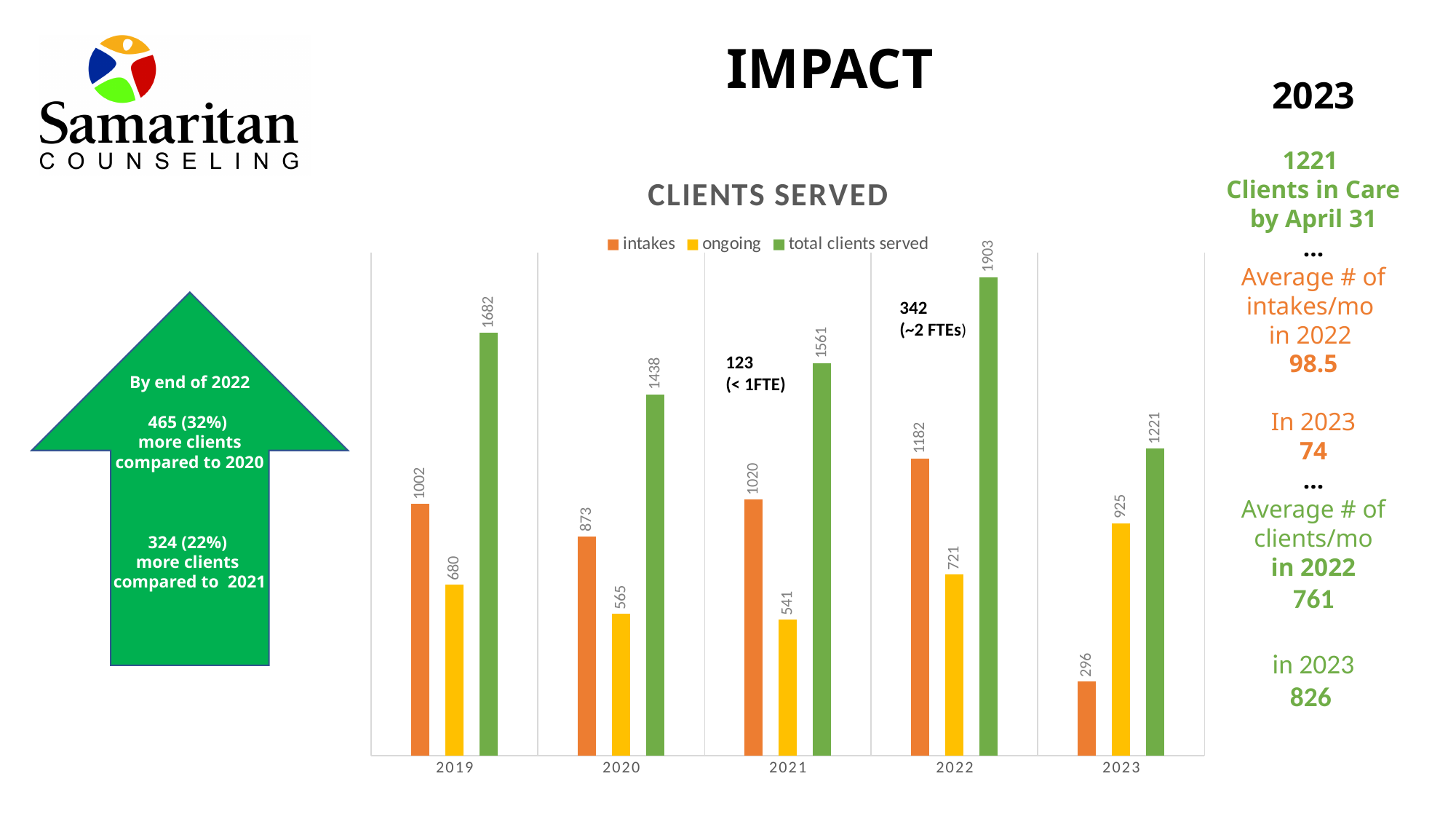
Which is larger, ongoing in 2019 or ongoing in 2020? ongoing in 2019 What kind of chart is shown? bar chart How many years are shown on the x axis? 5 What is the title of the chart? CLIENTS SERVED What is the value for intakes in 2019? 1002 What is the value for total clients served in 2022? 1903 Which year has the lowest value for intakes? 2023 What is the difference between total clients served in 2022 and in 2021? 342 Does the value for intakes rise or fall from 2022 to 2023? fall Which year has the highest value for total clients served? 2022 How many series does the legend list? 3 What is the value for ongoing in 2023? 925